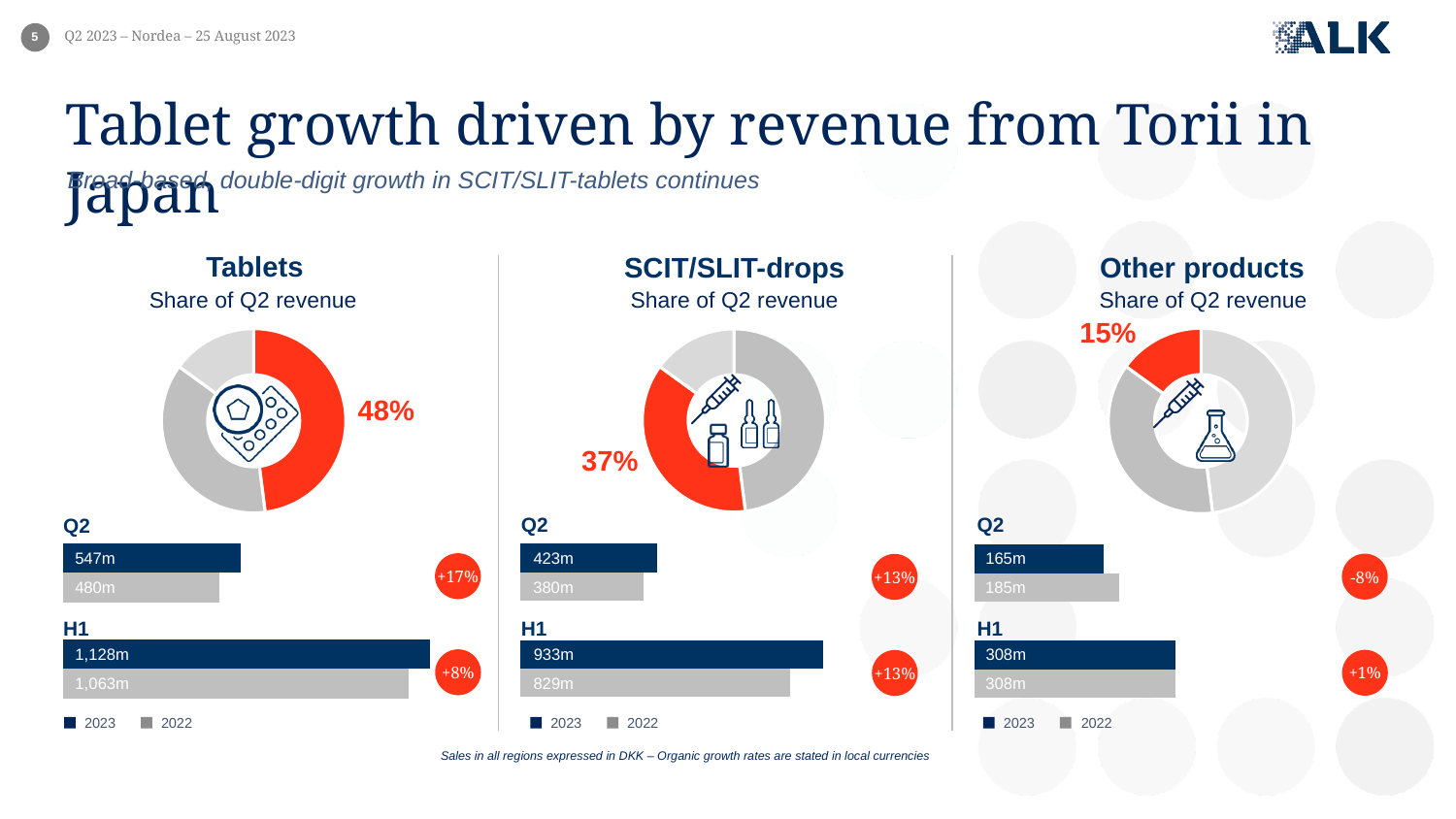
In the Other products bar chart, which is larger, the Q2 2023 value or the Q2 2022 value? Q2 2022 In the SCIT/SLIT-drops bar chart, what is the difference between the H1 2023 and H1 2022 values? 104m In the Tablets chart, what share of Q2 revenue do tablets represent? 48% What kind of chart shows the share of Q2 revenue in the Tablets panel? Donut (pie) chart How many series does the legend list in the Tablets bar chart? 2 In the Tablets bar chart, what is the difference between the Q2 2023 and Q2 2022 values? 67m In the Other products chart, what share of Q2 revenue do other products represent? 15% In the Tablets bar chart, what is the H1 2022 value? 1,063m In the Other products bar chart, what is the H1 2023 value? 308m In the Tablets bar chart, what is the Q2 2023 value? 547m In the SCIT/SLIT-drops bar chart, what is the Q2 2022 value? 380m In the SCIT/SLIT-drops chart, what share of Q2 revenue do SCIT/SLIT-drops represent? 37%